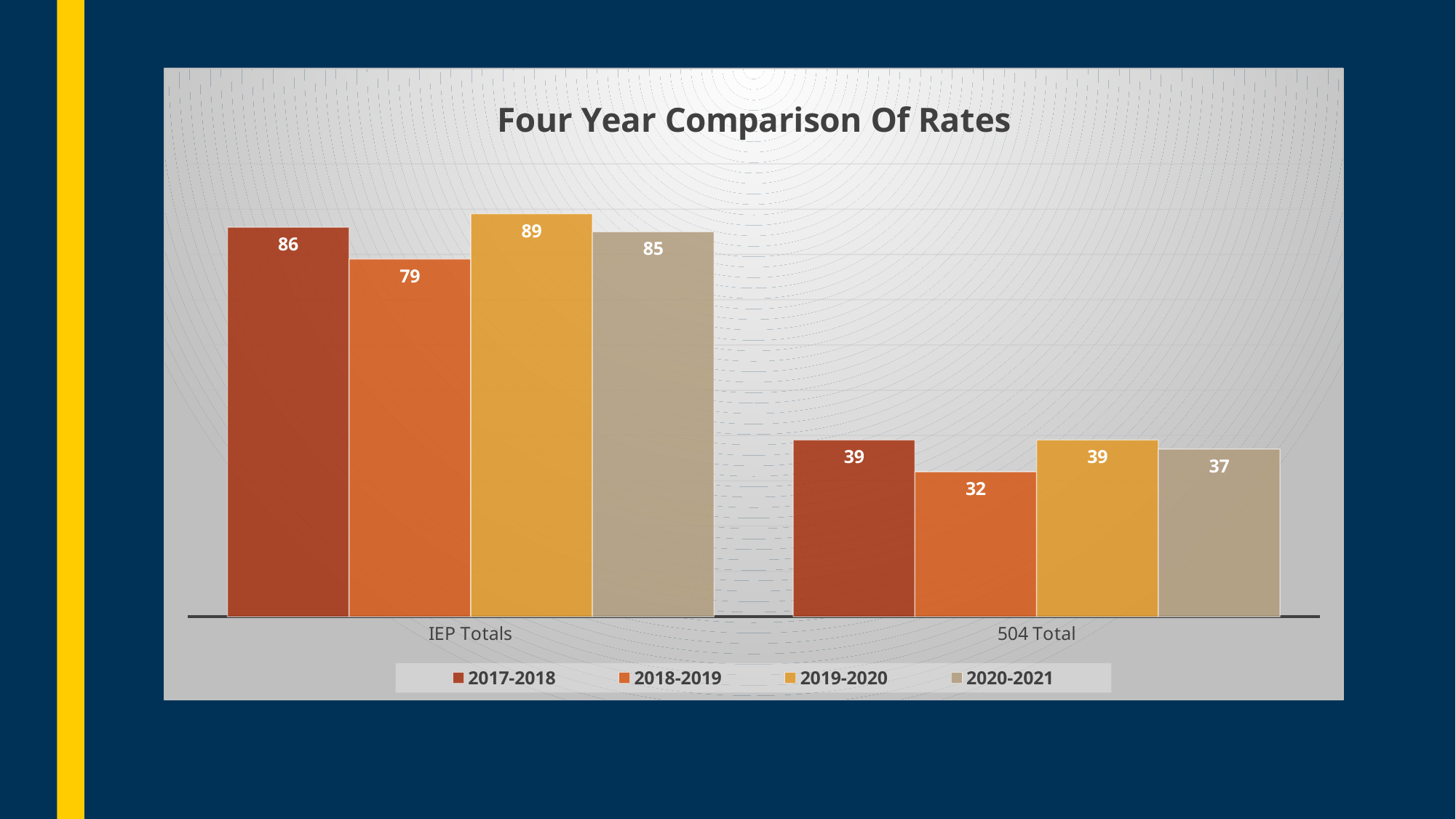
Which is larger: the 2017-2018 value for IEP Totals or the 2020-2021 value for IEP Totals? 2017-2018 Which year has the lowest value in the 504 Total category? 2018-2019 How many series does the legend list? 4 What is the difference between the 2017-2018 and 2020-2021 values in the 504 Total category? 2 What is the value for 2018-2019 in the 504 Total category? 32 Which year has the highest value in the IEP Totals category? 2019-2020 What kind of chart is shown on the slide? Bar chart What is the title of the chart? Four Year Comparison Of Rates What is the value for 2017-2018 in the IEP Totals category? 86 What is the value for 2020-2021 in the IEP Totals category? 85 How many categories are shown on the x axis? 2 What is the difference between the 2019-2020 and 2018-2019 values in the IEP Totals category? 10